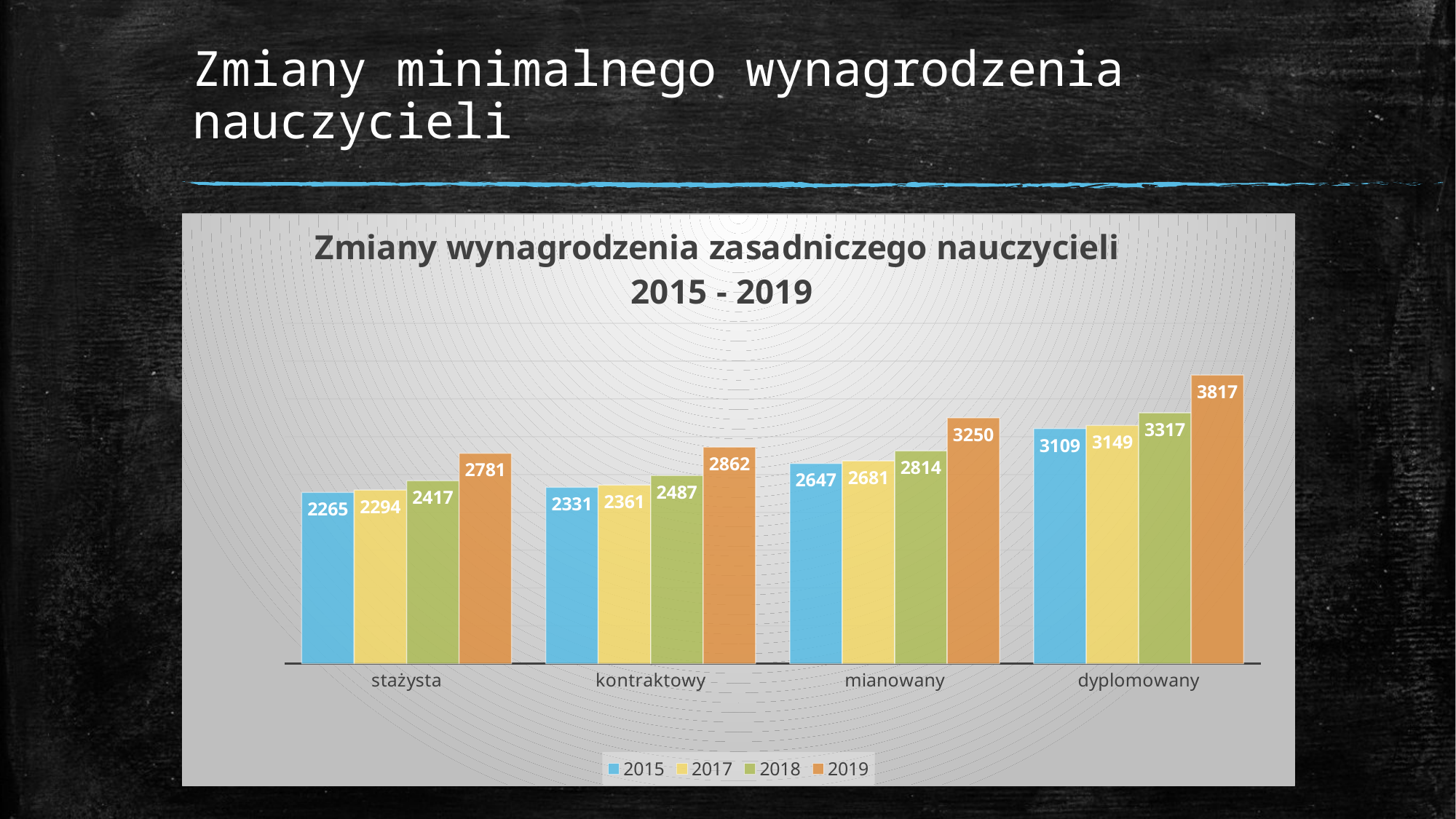
Which is larger: the 2018 value for kontraktowy or the 2015 value for mianowany? the 2015 value for mianowany What is the value for mianowany in 2018? 2814 What kind of chart is shown on the slide? bar chart What is the difference between the 2019 values for mianowany and kontraktowy? 388 How many series does the legend list? 4 What is the value for dyplomowany in 2019? 3817 What is the value for kontraktowy in 2017? 2361 What is the difference between the 2019 and 2015 values for dyplomowany? 708 What is the value for stażysta in 2015? 2265 How many categories are shown on the x axis? 4 Which category has the lowest value in 2015? stażysta Which category has the highest value in 2019? dyplomowany